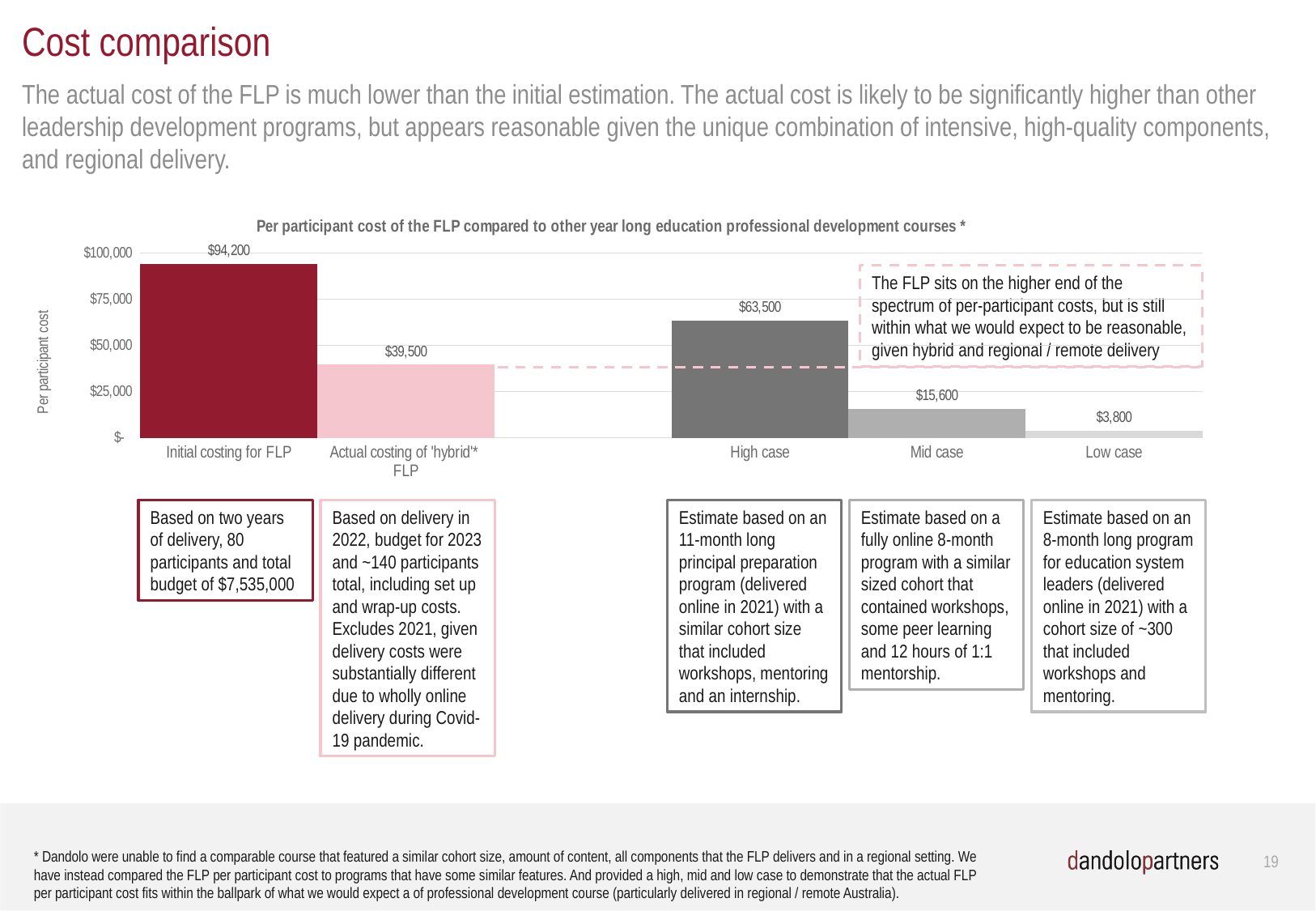
Which category has the highest per participant cost? Initial costing for FLP What is the difference between the 'Initial costing for FLP' and the 'Actual costing of 'hybrid' FLP'? $54,700 What is the value shown for the 'High case' bar? $63,500 What is the value shown for the 'Low case' bar? $3,800 What is the per participant cost shown for 'Actual costing of 'hybrid' FLP'? $39,500 Is the value for 'Mid case' greater or less than $25,000? less How many bars are plotted in the chart? 5 Which is larger, the 'Actual costing of 'hybrid' FLP' or the 'High case'? High case What type of chart is shown on the slide? Bar chart What is the per participant cost shown for 'Initial costing for FLP'? $94,200 What is the difference between the 'High case' and the 'Mid case' values? $47,900 Which category has the lowest per participant cost? Low case